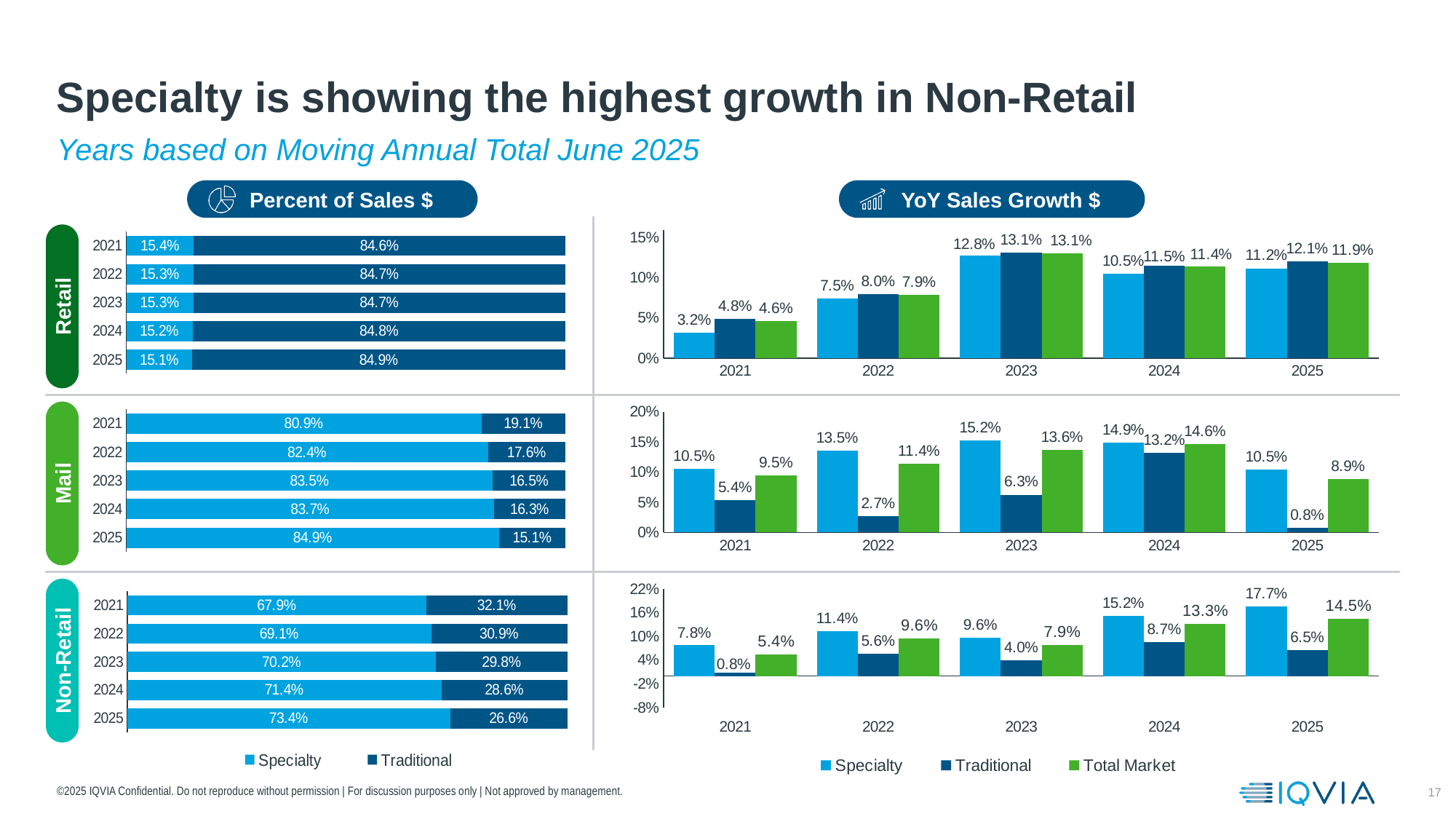
In the Percent of Sales $ chart for Non-Retail, which year has the highest Specialty share? 2025 In the YoY Sales Growth $ chart for Mail, what is the Traditional growth in 2025? 0.8% In the YoY Sales Growth $ chart for Retail, what is the Specialty growth in 2021? 3.2% In the YoY Sales Growth $ chart for Retail, which year has the highest Total Market growth? 2023 In the YoY Sales Growth $ chart for Non-Retail, which is larger in 2024: Specialty growth or Total Market growth? Specialty In the Percent of Sales $ chart for Non-Retail, what is the difference between the Specialty share in 2025 and in 2021? 5.5 percentage points What kind of chart is the Percent of Sales $ chart for Retail? Stacked bar chart In the Percent of Sales $ chart for Mail, what is the Traditional share in 2021? 19.1% In the YoY Sales Growth $ chart for Mail, which year has the lowest Traditional growth? 2025 In the YoY Sales Growth $ chart for Non-Retail, what is the Specialty growth in 2025? 17.7% In the Percent of Sales $ chart for Retail, what is the Specialty share in 2025? 15.1% How many series does the legend of the YoY Sales Growth $ charts list? 3